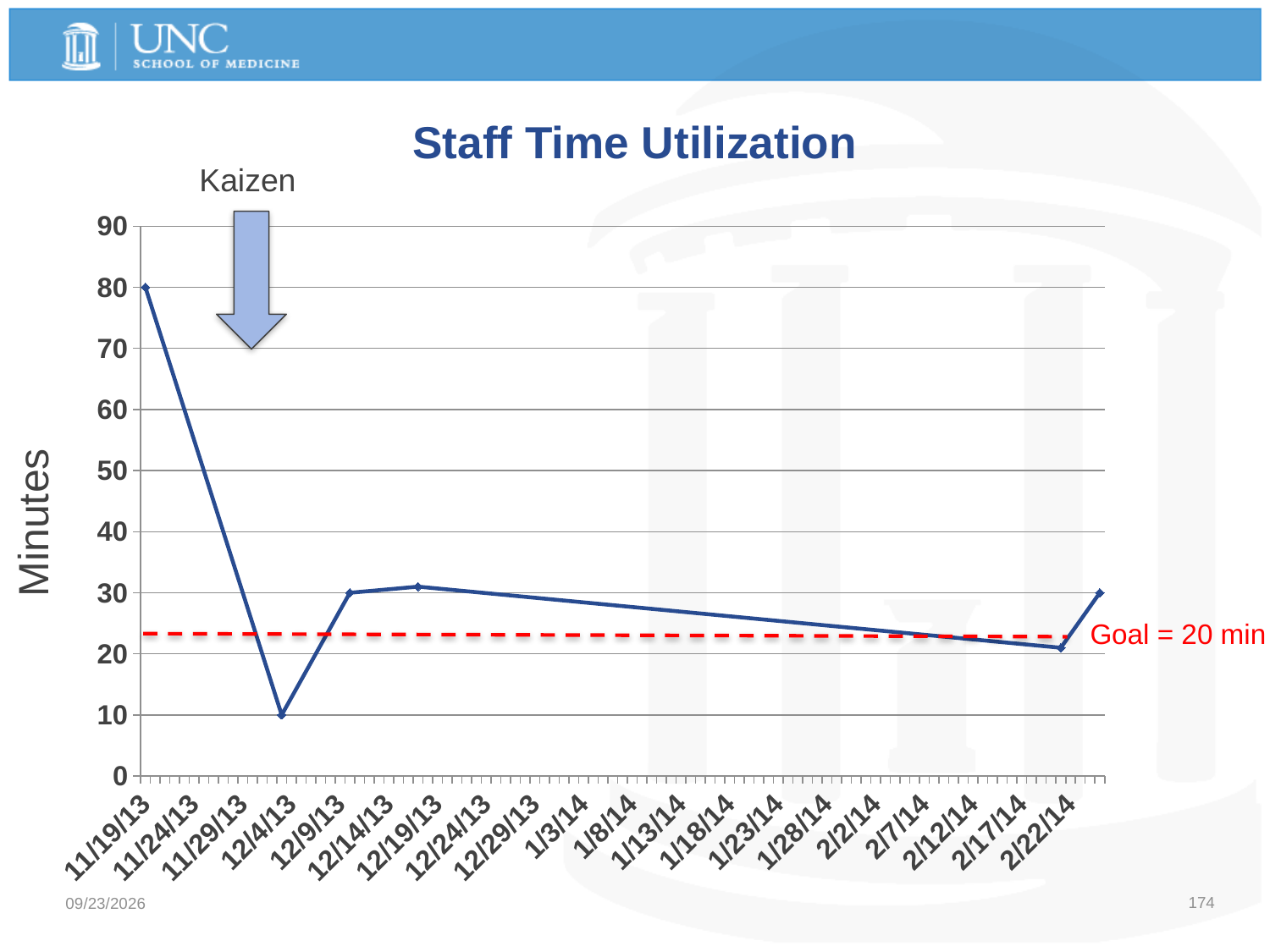
What kind of chart is shown on the slide? line chart What goal value is labelled next to the dashed red line? Goal = 20 min What is the value for 11/19/13? 80 Which date has the highest value? 11/19/13